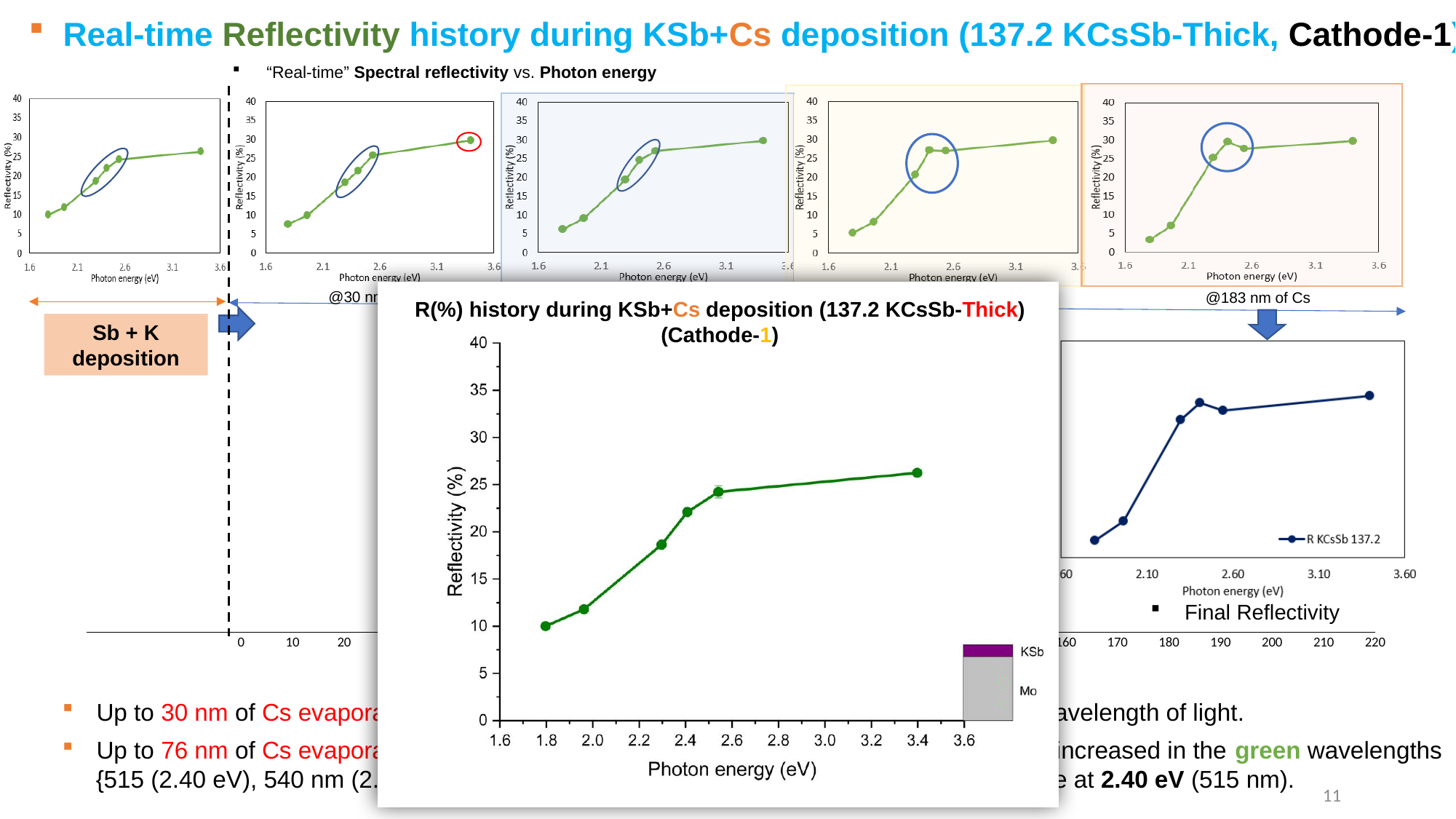
In the large central chart, does reflectivity rise or fall as photon energy increases from 1.8 eV to 3.4 eV? Rise What type of chart is the large central chart titled "R(%) history during KSb+Cs deposition (137.2 KCsSb-Thick) (Cathode-1)"? Line chart In the large central chart, is the reflectivity at about 1.8 eV greater or less than 15%? less In the chart on the right side of the slide, is the reflectivity at about 1.8 eV greater or less than 25%? less What is the x-axis label of the large central chart? Photon energy (eV) What is the y-axis label of the large central chart? Reflectivity (%) In the large central chart, is the reflectivity at about 2.3 eV greater or less than 15%? greater In the chart on the right side of the slide, what series name does the legend show? R KCsSb 137.2 In the large central chart, which plotted point has the lowest reflectivity, the one at about 1.8 eV or the one at about 3.4 eV? The one at about 1.8 eV In the large central chart, how many data points are plotted on the line? 6